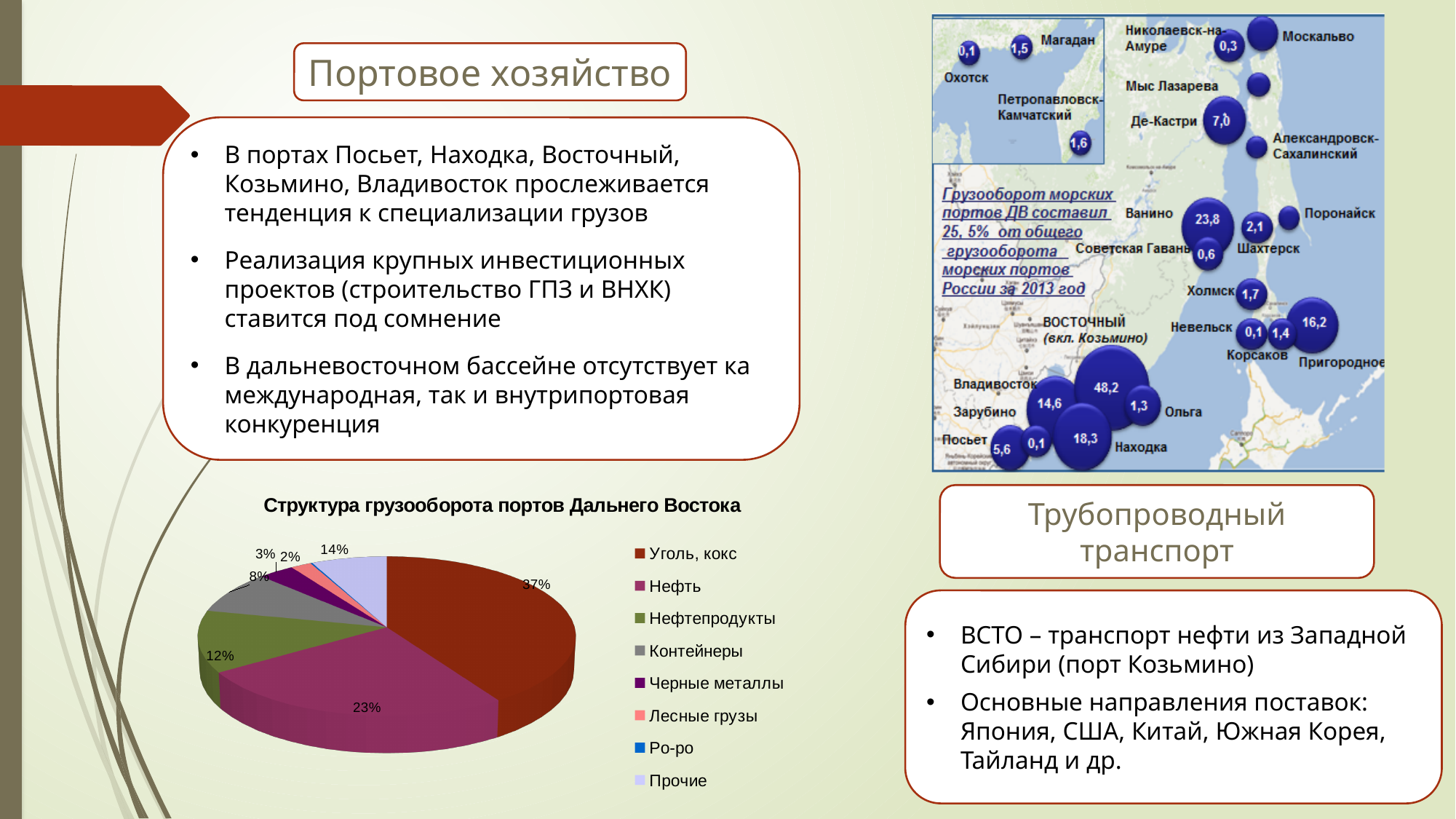
In the pie chart, by how many percentage points does 'Уголь, кокс' exceed 'Нефть'? 14 In the pie chart, what share is shown for 'Черные металлы'? 3% In the pie chart, what share is shown for 'Нефть'? 23% Which category has the smallest slice in the pie chart? Ро-ро Which category has the largest slice in the pie chart? Уголь, кокс In the pie chart, what share is shown for 'Прочие'? 14% In the pie chart, what share is shown for 'Нефтепродукты'? 12% In the pie chart, what share is shown for 'Контейнеры'? 8% In the pie chart, what share is shown for 'Уголь, кокс'? 37% What kind of chart is shown under the title 'Структура грузооборота портов Дальнего Востока'? pie chart How many categories does the legend of the pie chart list? 8